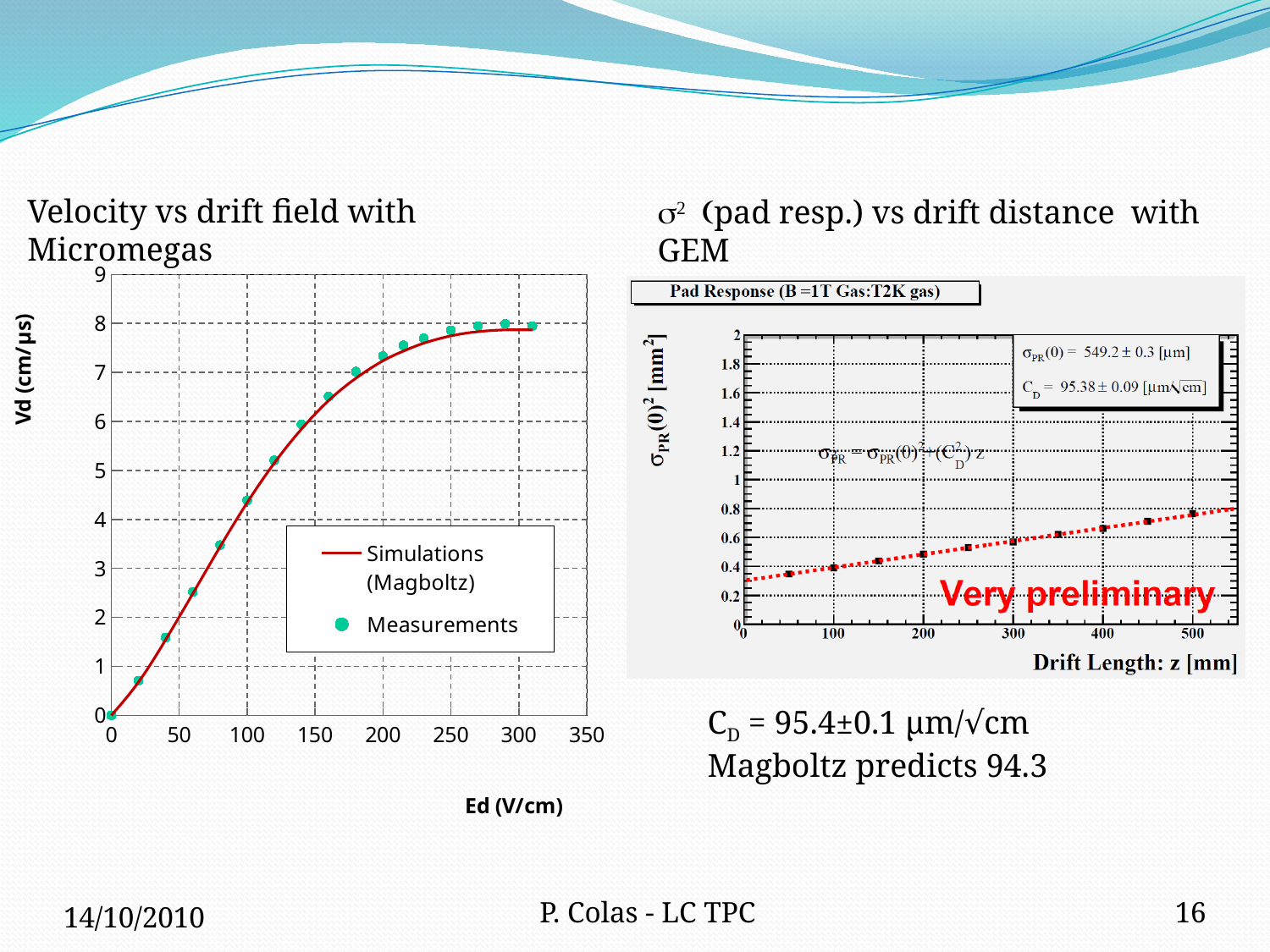
On the right chart (Pad Response), how many data points are plotted? 10 On the right chart (Pad Response), is the value at z = 50 mm greater or less than 0.4 mm²? less On the right chart (Pad Response), does σ_PR(0)² rise or fall as the drift length z increases? Rise On the left chart (Velocity vs drift field with Micromegas), what kind of chart is it? Line chart with scatter points On the left chart (Velocity vs drift field with Micromegas), is the measured velocity at Ed = 200 V/cm greater or less than 7 cm/µs? greater On the right chart (Pad Response), is the value at z = 500 mm greater or less than 0.6 mm²? greater On the left chart (Velocity vs drift field with Micromegas), what is the label of the x axis? Ed (V/cm) On the left chart (Velocity vs drift field with Micromegas), how many series does the legend list? 2 On the left chart (Velocity vs drift field with Micromegas), does the drift velocity rise or fall as Ed increases? Rise On the left chart (Velocity vs drift field with Micromegas), what are the two legend entries? Simulations (Magboltz) and Measurements